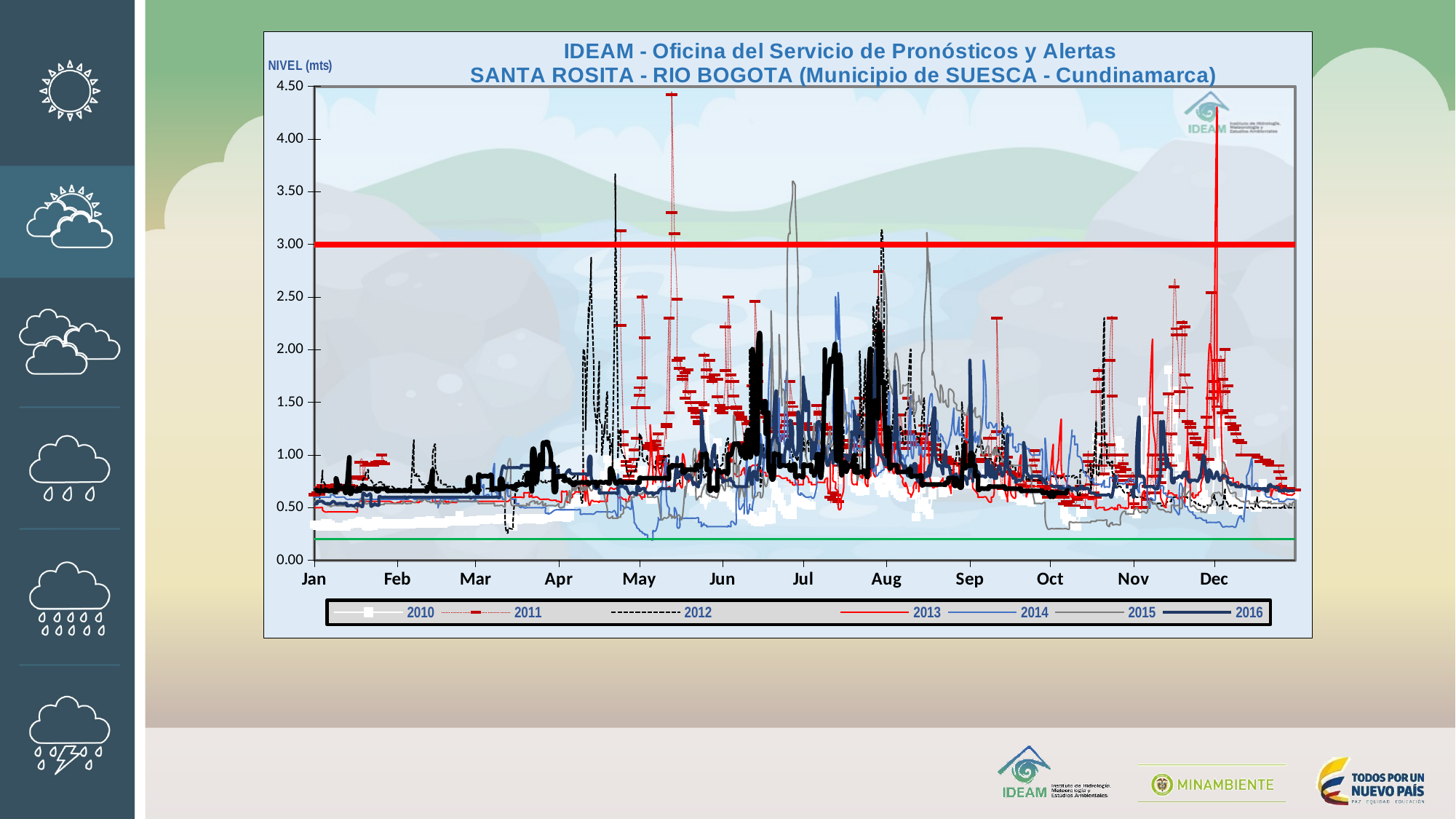
What is the label of the y axis? NIVEL (mts) How many months are labelled along the x axis? 12 Which station and river are named in the chart title? SANTA ROSITA - RIO BOGOTA Is the peak of the 2015 series in early July greater or less than 3.00? greater Is the highest peak of the 2011 series, in May, greater or less than 4.00? greater How many series does the legend list? 7 Is the value of the 2010 series in January greater or less than 0.50? less At what level is the thick red horizontal line drawn across the chart? 3.00 What kind of chart is shown on the slide? line chart